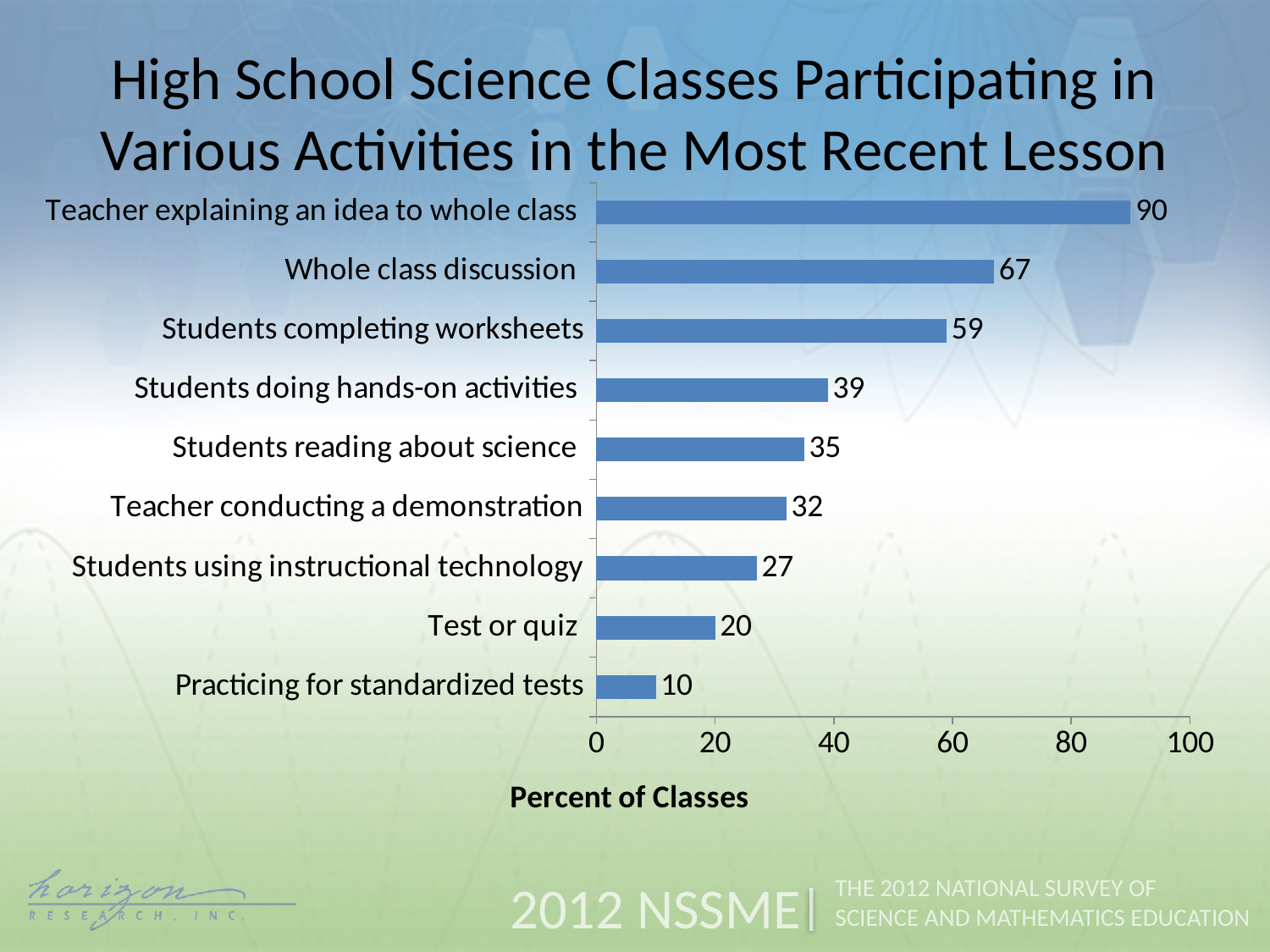
Is the value for Whole class discussion greater or less than 60? greater What is the difference between Students reading about science and Teacher conducting a demonstration? 3 Which is larger: Students using instructional technology or Test or quiz? Students using instructional technology What is the value for Test or quiz? 20 What is the difference between Whole class discussion and Students completing worksheets? 8 What is the value for Students doing hands-on activities? 39 What kind of chart is shown on the slide? Bar chart What is the label of the horizontal axis? Percent of Classes Which activity has the lowest percent of classes? Practicing for standardized tests What percent of classes had the teacher explaining an idea to the whole class? 90 How many activities are shown in the chart? 9 Which activity has the highest percent of classes? Teacher explaining an idea to whole class